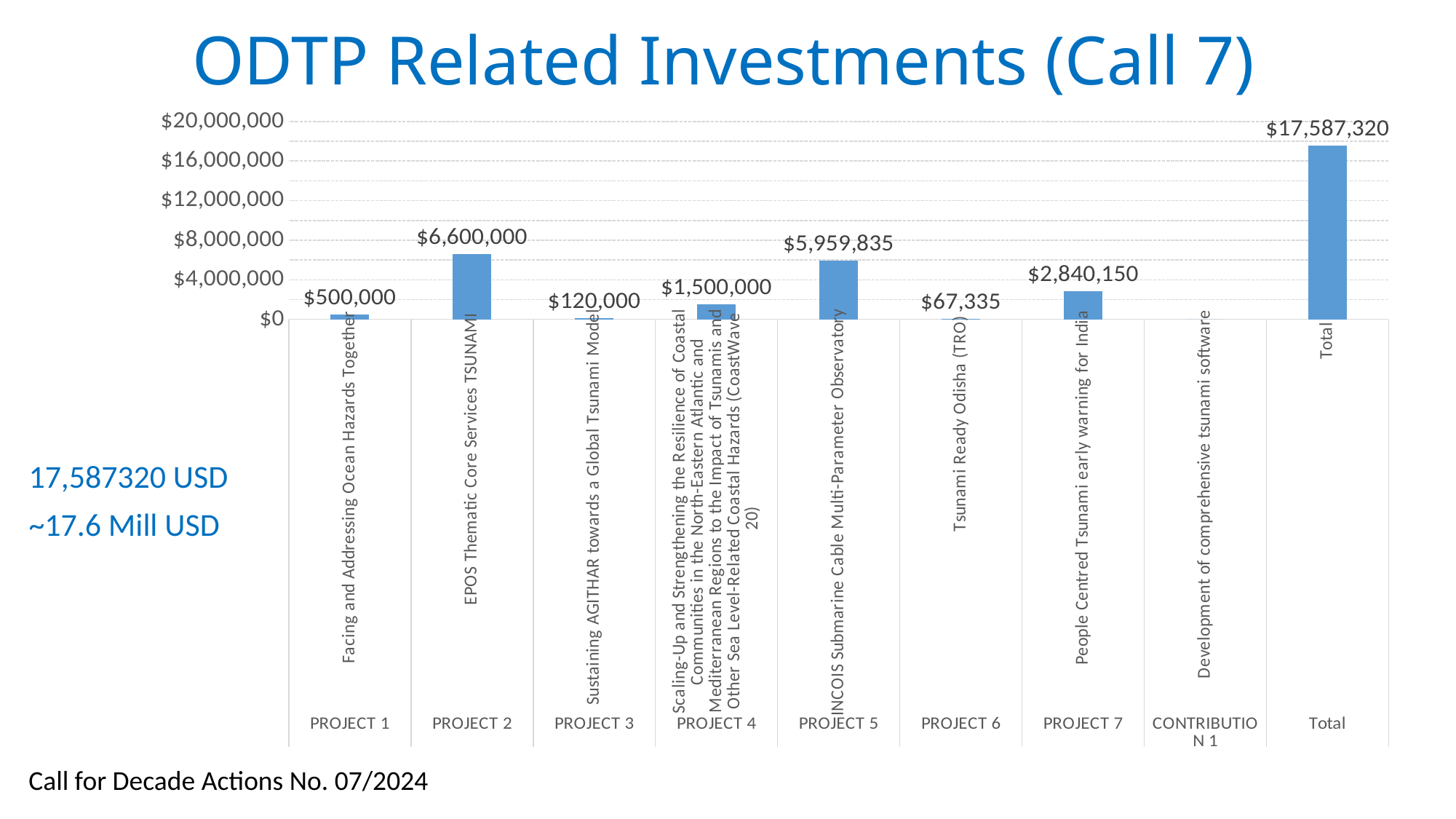
What is the value shown for the Total bar? $17,587,320 Is the value for the Total bar greater or less than $16,000,000? greater What is the value for Project 6 (Tsunami Ready Odisha (TRO))? $67,335 What is the difference between the values for Project 7 and Project 4? $1,340,150 Which is larger, the value for Project 1 or the value for Project 3? Project 1 What is the difference between the values for Project 2 and Project 5? $640,165 What kind of chart is shown on the slide? bar chart What is the value for Project 2 (EPOS Thematic Core Services TSUNAMI)? $6,600,000 Among Projects 1 to 7, which project has the lowest investment? Project 6 What is the value for Project 5 (INCOIS Submarine Cable Multi-Parameter Observatory)? $5,959,835 What is the title of the chart? ODTP Related Investments (Call 7) Among Projects 1 to 7, which project has the highest investment? Project 2